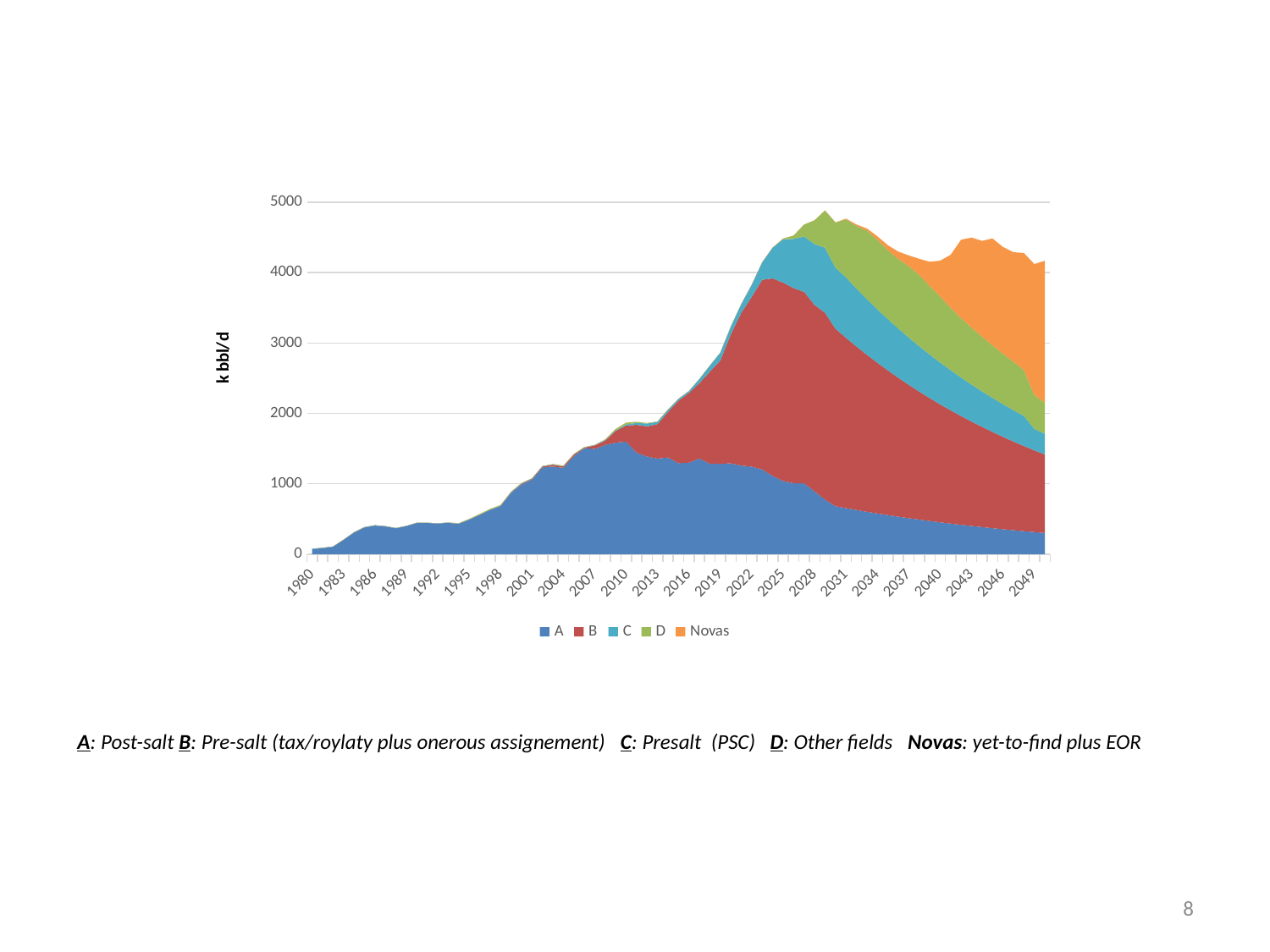
Does the value of series A rise or fall between 2010 and 2049? fall What are the series names listed in the legend? A, B, C, D, Novas Is the total value in 2028 greater or less than 4000? greater Does the total value rise or fall between 1980 and 2025? rise Is the total value in 2004 greater or less than 1000? greater How many series does the legend list? 5 Is the total value in 1986 greater or less than 1000? less Which series is plotted at the bottom of the stack? A What kind of chart is shown on the slide? Stacked area chart In 2049, which series contributes more, Novas or A? Novas What is the label on the vertical axis? k bbl/d